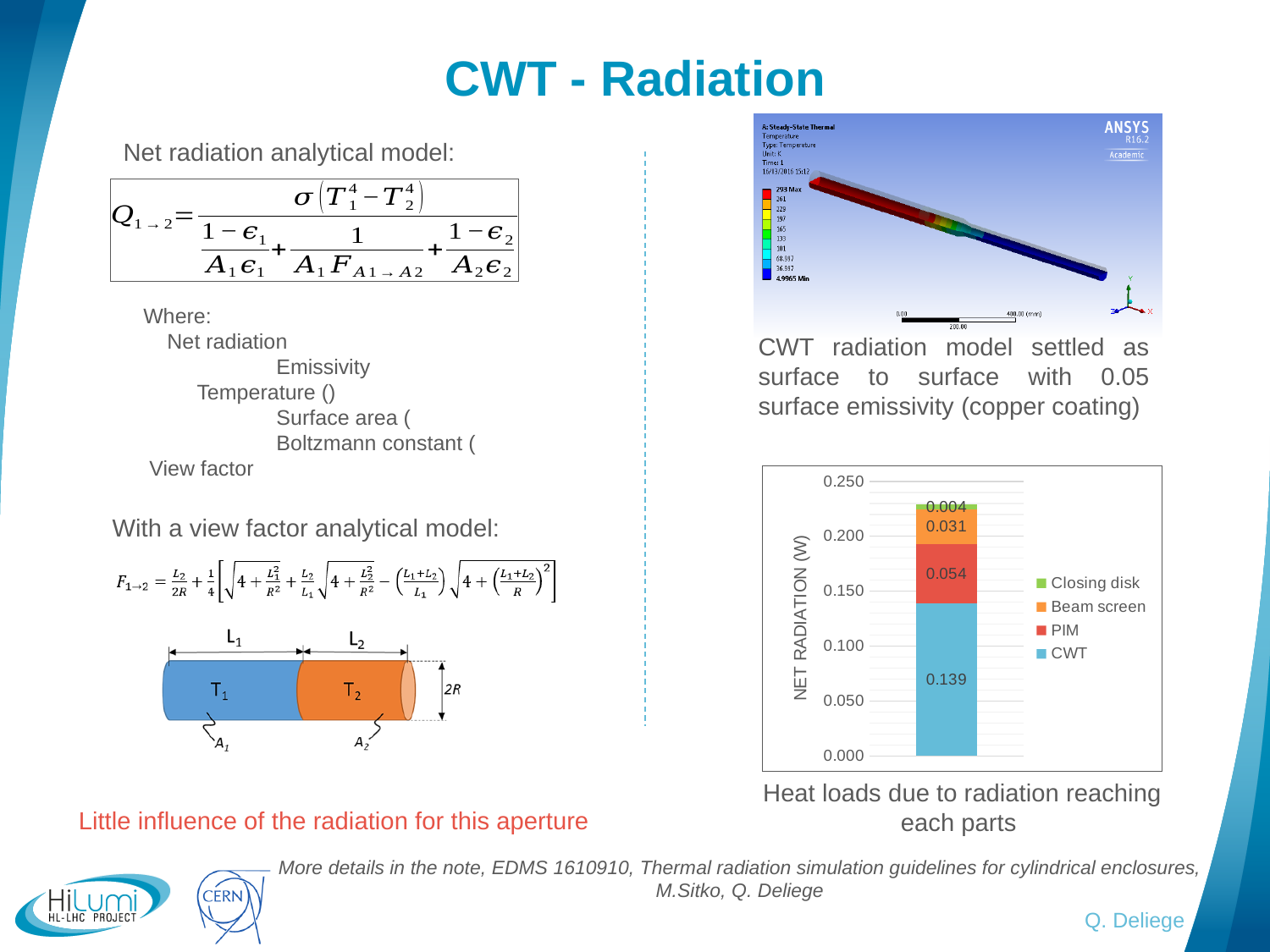
What is the total net radiation of the stacked bar? 0.228 What is the net radiation value for Beam screen in the chart? 0.031 Which series has the largest net radiation value in the chart? CWT What type of chart is shown on the slide? stacked bar chart What is the net radiation value for CWT in the chart? 0.139 How many series does the chart legend list? 4 Which is larger, the net radiation value for PIM or for Beam screen? PIM What is the net radiation value for Closing disk in the chart? 0.004 What is the label of the vertical axis of the chart? NET RADIATION (W) What is the net radiation value for PIM in the chart? 0.054 Which series has the smallest net radiation value in the chart? Closing disk What is the difference between the net radiation values for CWT and PIM? 0.085